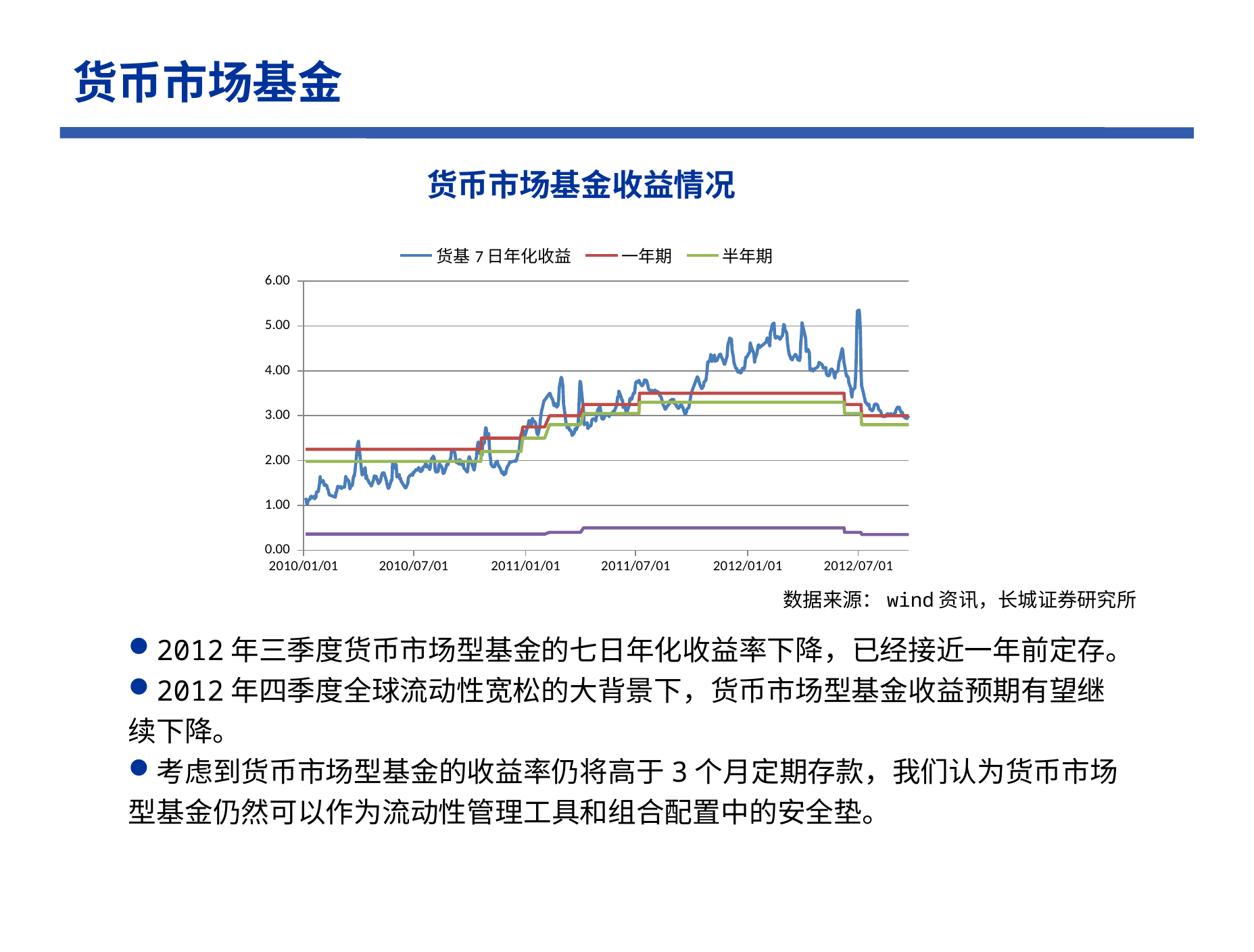
Is the highest value reached by the 一年期 series greater or less than 4.00? less Does the 货基7日年化收益 series generally rise or fall from 2010/01/01 to 2012/01/01? rise Which colour is used for the 一年期 series in the chart? red How many series does the chart legend list? 3 What kind of chart is shown on the slide? line chart Is the peak value of the 货基7日年化收益 series greater or less than 5.00? greater What is the title of the chart? 货币市场基金收益情况 At 2010/07/01, which series has the higher value: 一年期 or 半年期? 一年期 Is the value of the 一年期 series at 2010/01/01 greater or less than 2.00? greater At 2012/01/01, which series has the higher value: 货基7日年化收益 or 一年期? 货基7日年化收益 At 2010/01/01, which series has the higher value: 货基7日年化收益 or 一年期? 一年期